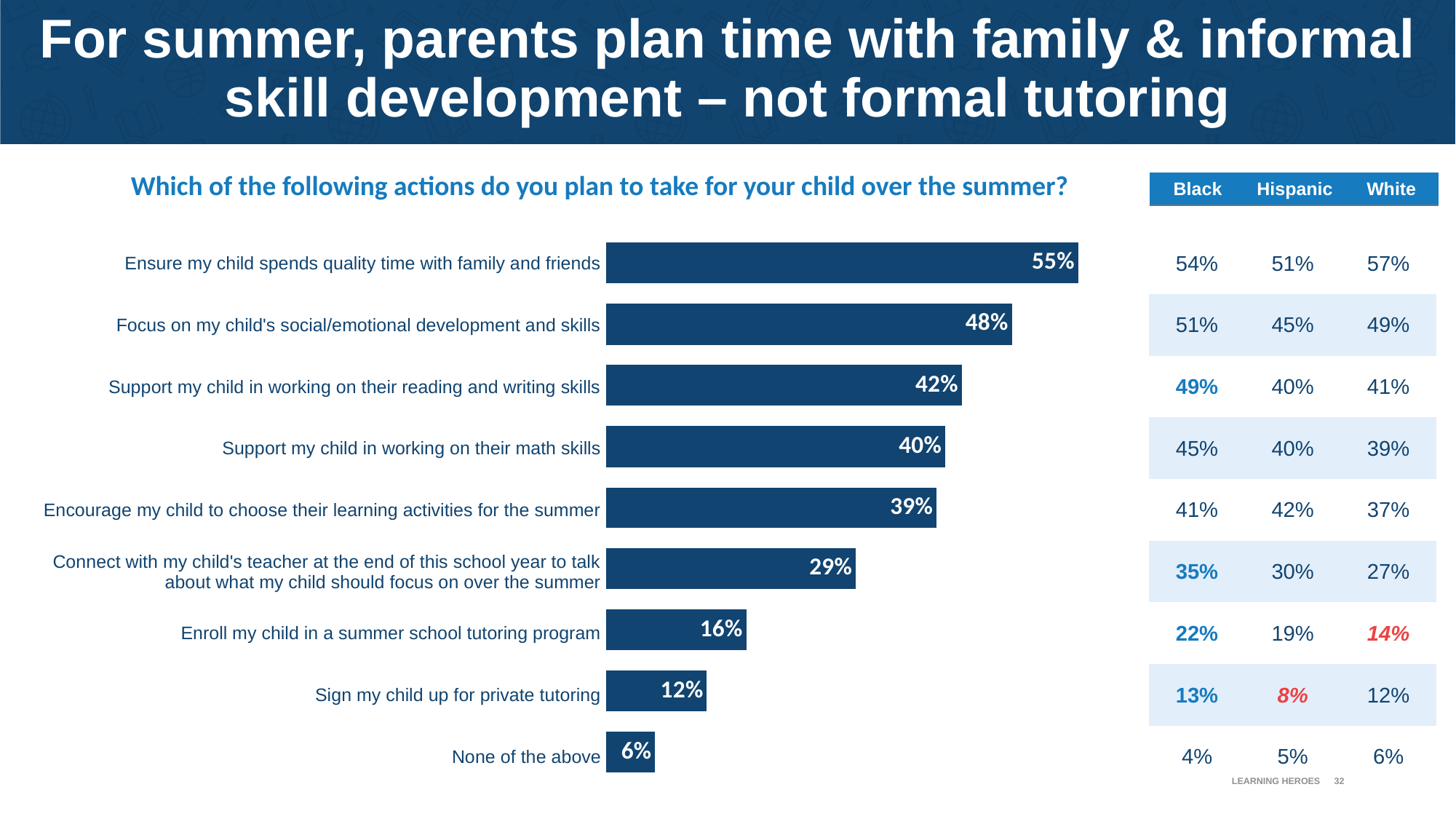
What type of chart is used to show the percentages of planned summer actions? Bar chart Which category has the lowest percentage in the bar chart? None of the above What percentage of parents plan to ensure their child spends quality time with family and friends? 55% Which action has the highest percentage in the bar chart? Ensure my child spends quality time with family and friends Which is larger: the percentage for connecting with the child's teacher or the percentage for enrolling in a summer school tutoring program? Connect with my child's teacher What question is the chart based on, as shown in the chart's title? Which of the following actions do you plan to take for your child over the summer? Do the bar values rise or fall going from the top category to the bottom category? Fall How many actions (categories) are shown in the bar chart? 9 What is the difference between the percentage for focusing on social/emotional development and the percentage for enrolling in a summer school tutoring program? 32% What is the difference between the percentage for supporting reading and writing skills and the percentage for supporting math skills? 2% What percentage of parents plan to sign their child up for private tutoring? 12% What percentage of parents plan to enroll their child in a summer school tutoring program? 16%